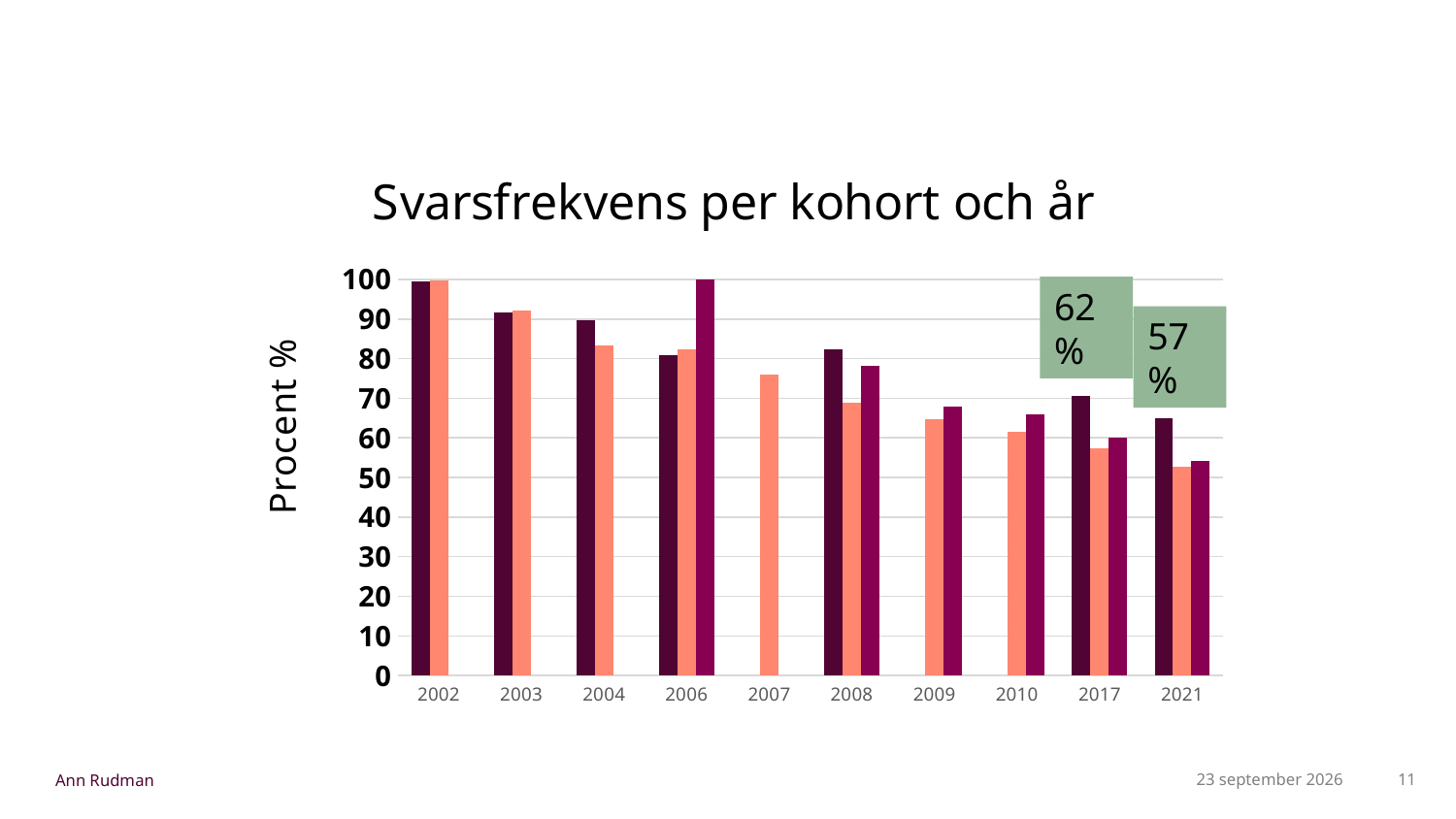
What is the label on the vertical axis of the chart? Procent % Which year has the lowest bar in the chart? 2021 Is the value of the bar for 2007 greater or less than 70? greater How many years are shown along the x axis of the chart? 10 What kind of chart is shown on the slide? bar chart Is the value of the salmon-coloured bar for 2021 greater or less than 60? less What is the title of the chart? Svarsfrekvens per kohort och år Which is larger, the dark purple bar for 2002 or the dark purple bar for 2021? 2002 Do the response rates generally rise or fall from 2002 to 2021? fall How many bars are plotted for the year 2007? 1 Is the value of the salmon-coloured bar for 2004 greater or less than 80? greater